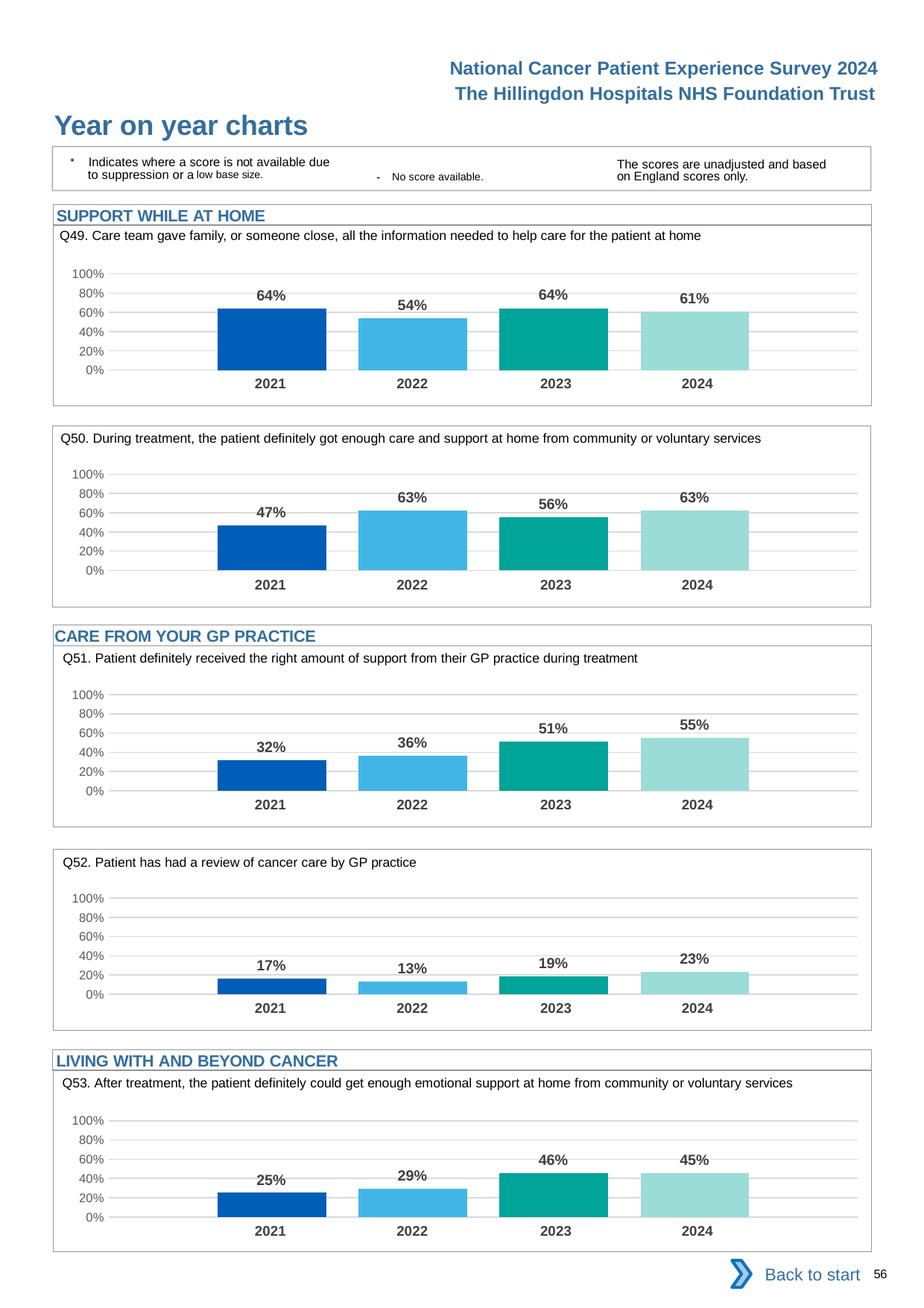
What kind of chart is the Q50 chart? bar chart In the Q51 chart, what is the difference between the 2024 and 2021 values? 23 percentage points In the Q49 chart, which is larger, the value for 2023 or the value for 2024? 2023 In the Q52 chart, which year has the highest value? 2024 In the Q51 chart, do the values rise or fall from 2021 to 2024? rise In the Q50 chart, what is the value for 2023? 56% In the Q53 chart, what is the value for 2023? 46% In the Q49 chart, what is the value for 2022? 54% In the Q53 chart, what is the difference between the 2022 and 2021 values? 4 percentage points In the Q50 chart, which year has the lowest value? 2021 Which section heading appears above the Q53 chart? LIVING WITH AND BEYOND CANCER In the Q52 chart, how many years are plotted? 4